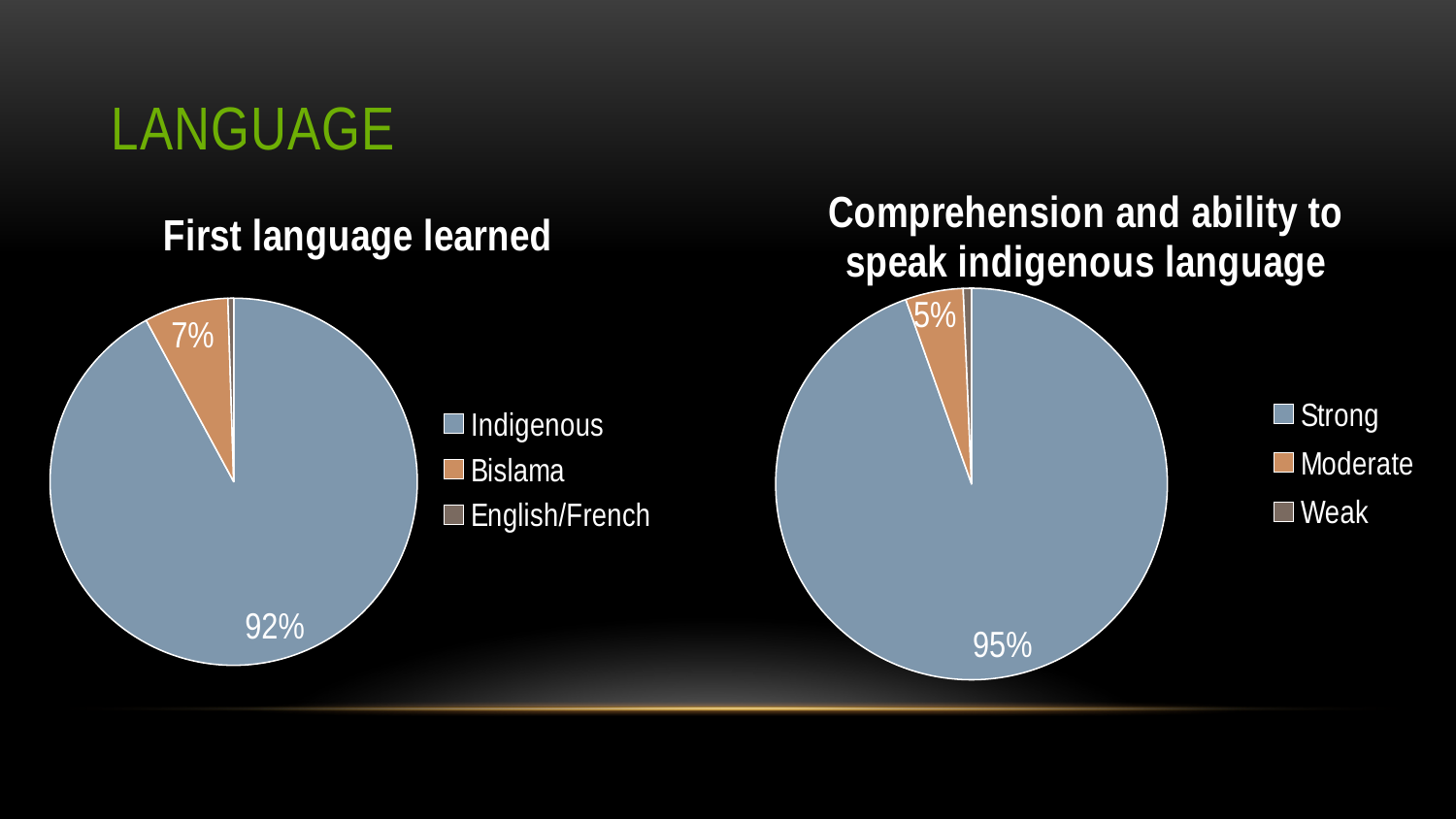
In the 'Comprehension and ability to speak indigenous language' chart, what colour represents the Moderate category? Orange In the 'First language learned' chart, what share does Bislama have? 7% In the 'Comprehension and ability to speak indigenous language' chart, what share is Moderate? 5% In the 'First language learned' chart, which category has the smallest slice? English/French In the 'Comprehension and ability to speak indigenous language' chart, what percentage is Strong? 95% In the 'First language learned' chart, which category has the largest slice? Indigenous In the 'First language learned' chart, how many categories does the legend list? 3 In the 'First language learned' chart, what percentage of respondents learned an Indigenous language first? 92% In the 'Comprehension and ability to speak indigenous language' chart, which is larger, Strong or Moderate? Strong What type of chart is used for 'First language learned'? Pie chart In the 'Comprehension and ability to speak indigenous language' chart, which category has the smallest slice? Weak In the 'First language learned' chart, what is the difference between the Indigenous and Bislama shares? 85%